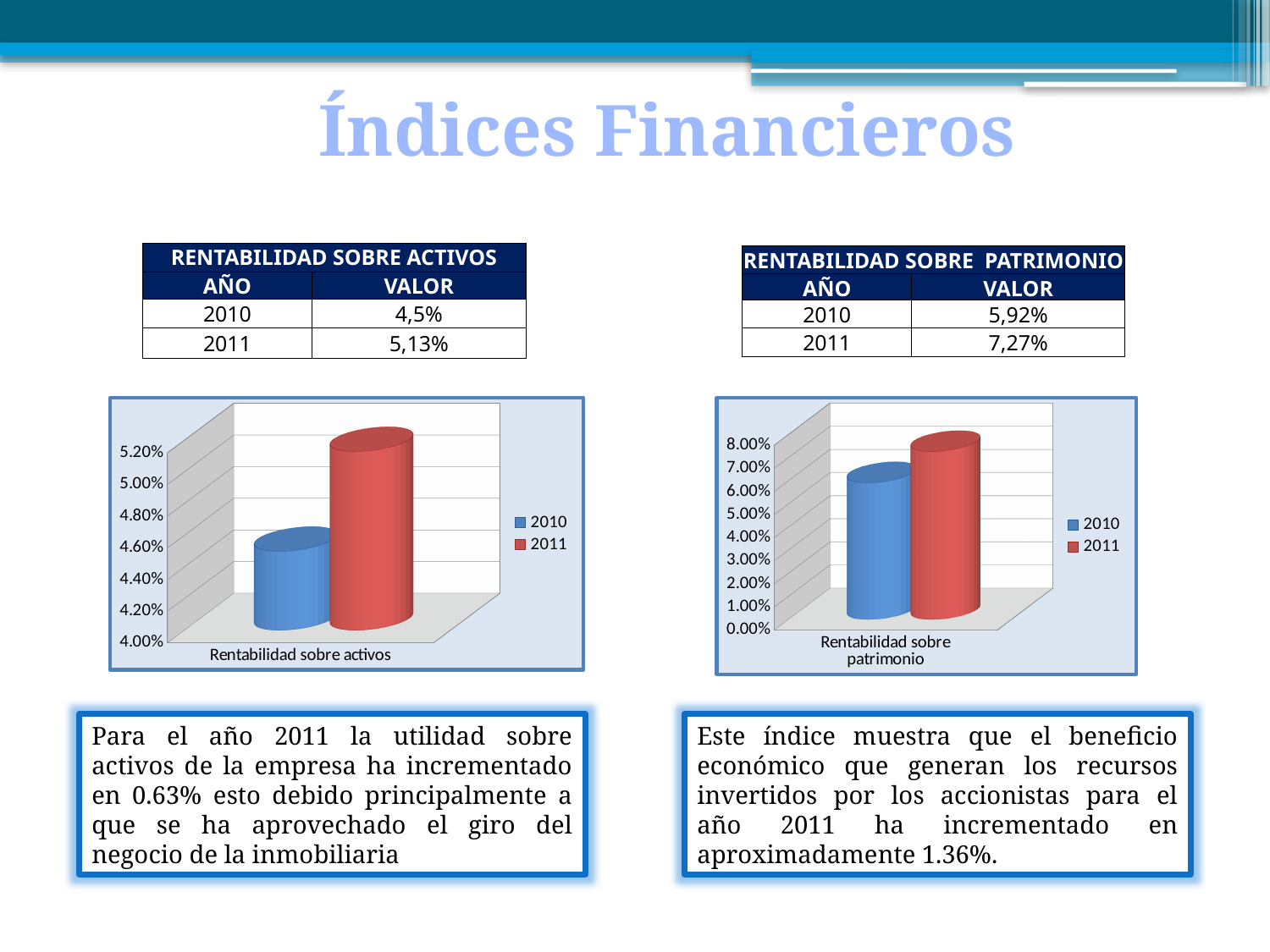
In the 'Rentabilidad sobre activos' chart on the left, which series has the taller bar, 2010 or 2011? 2011 How many categories are shown on the x axis of the 'Rentabilidad sobre patrimonio' chart on the right? 1 According to the table above the right chart, what is the 'Rentabilidad sobre patrimonio' value for 2010? 5,92% In the 'Rentabilidad sobre activos' chart on the left, what colour is the bar for the 2011 series? red What kind of chart is the 'Rentabilidad sobre activos' chart on the left? bar chart In the 'Rentabilidad sobre patrimonio' chart on the right, which series has the lower bar? 2010 In the 'Rentabilidad sobre patrimonio' chart on the right, is the value for 2010 greater or less than 5.00%? greater In the 'Rentabilidad sobre activos' chart on the left, is the value for 2011 greater or less than 5.00%? greater In the 'Rentabilidad sobre patrimonio' chart on the right, is the value for 2011 greater or less than 6.00%? greater According to the table above the left chart, what is the 'Rentabilidad sobre activos' value for 2011? 5,13% How many series does the legend of the 'Rentabilidad sobre patrimonio' chart on the right list? 2